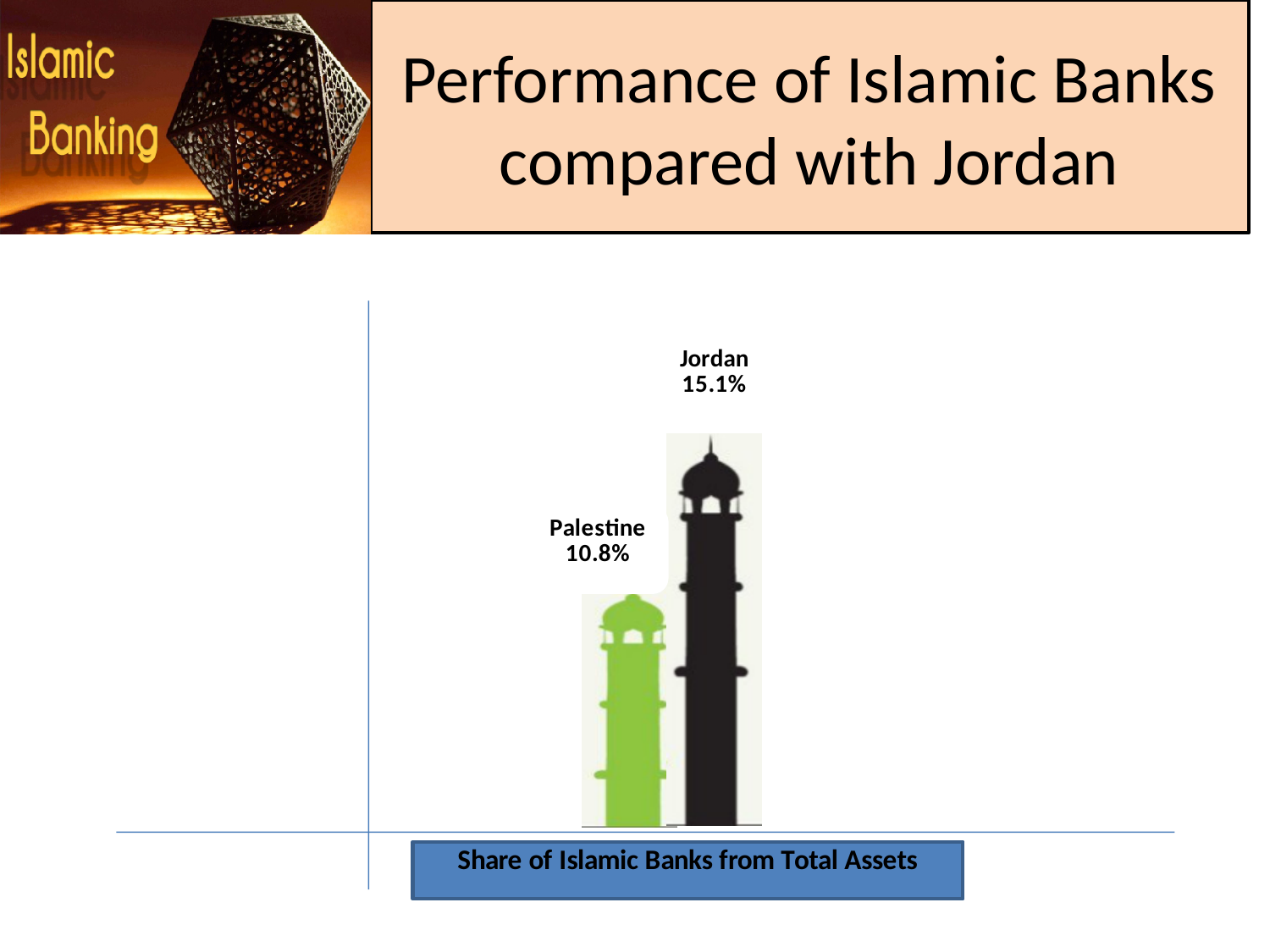
What colour is the bar representing Palestine? green Is the value for Palestine larger or smaller than the value for Jordan? smaller What is the share of Islamic banks from total assets for Palestine? 10.8% What kind of chart is shown on the slide? bar chart What is the share of Islamic banks from total assets for Jordan? 15.1% What is the difference in percentage points between Jordan's and Palestine's share of Islamic banks from total assets? 4.3 percentage points What is the title shown beneath the chart? Share of Islamic Banks from Total Assets Which country has the higher share of Islamic banks from total assets? Jordan Which country has the lower share of Islamic banks from total assets? Palestine How many countries are shown in the chart? 2